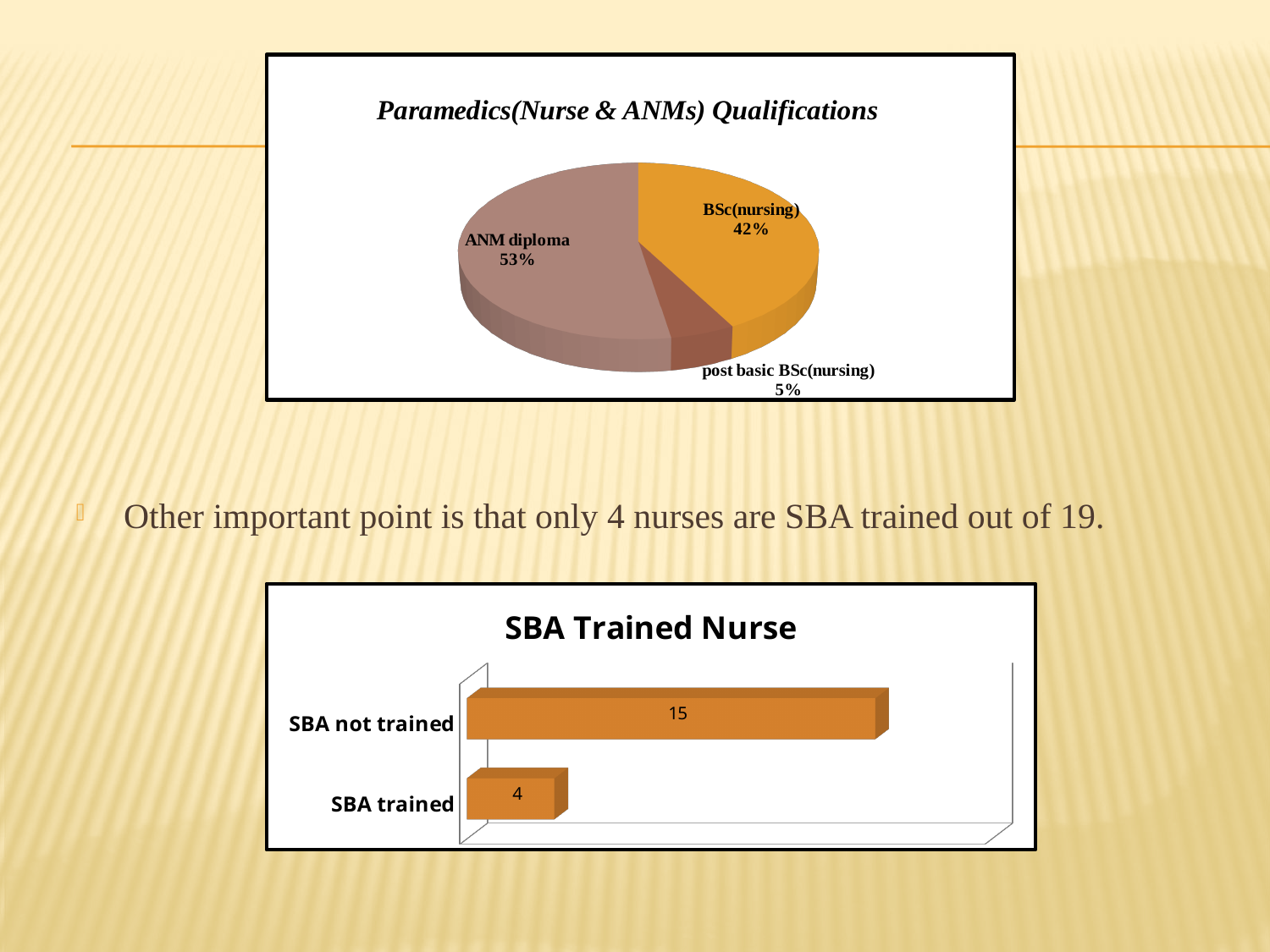
In the 'SBA Trained Nurse' chart, what is the value for SBA not trained? 15 In the 'SBA Trained Nurse' chart, what is the value for SBA trained? 4 In the 'SBA Trained Nurse' chart, what is the difference between SBA not trained and SBA trained? 11 In the 'Paramedics(Nurse & ANMs) Qualifications' chart, how many percentage points larger is the ANM diploma share than the BSc(nursing) share? 11 In the 'Paramedics(Nurse & ANMs) Qualifications' chart, how many slices does the pie have? 3 In the 'Paramedics(Nurse & ANMs) Qualifications' chart, what percentage is shown for BSc(nursing)? 42% In the 'Paramedics(Nurse & ANMs) Qualifications' chart, what percentage is shown for post basic BSc(nursing)? 5% What kind of chart is the 'Paramedics(Nurse & ANMs) Qualifications' chart? Pie chart What kind of chart is the 'SBA Trained Nurse' chart? Bar chart In the 'Paramedics(Nurse & ANMs) Qualifications' chart, which qualification has the smallest share? post basic BSc(nursing) In the 'Paramedics(Nurse & ANMs) Qualifications' chart, which qualification has the largest share? ANM diploma In the 'Paramedics(Nurse & ANMs) Qualifications' chart, what share of the pie is ANM diploma? 53%